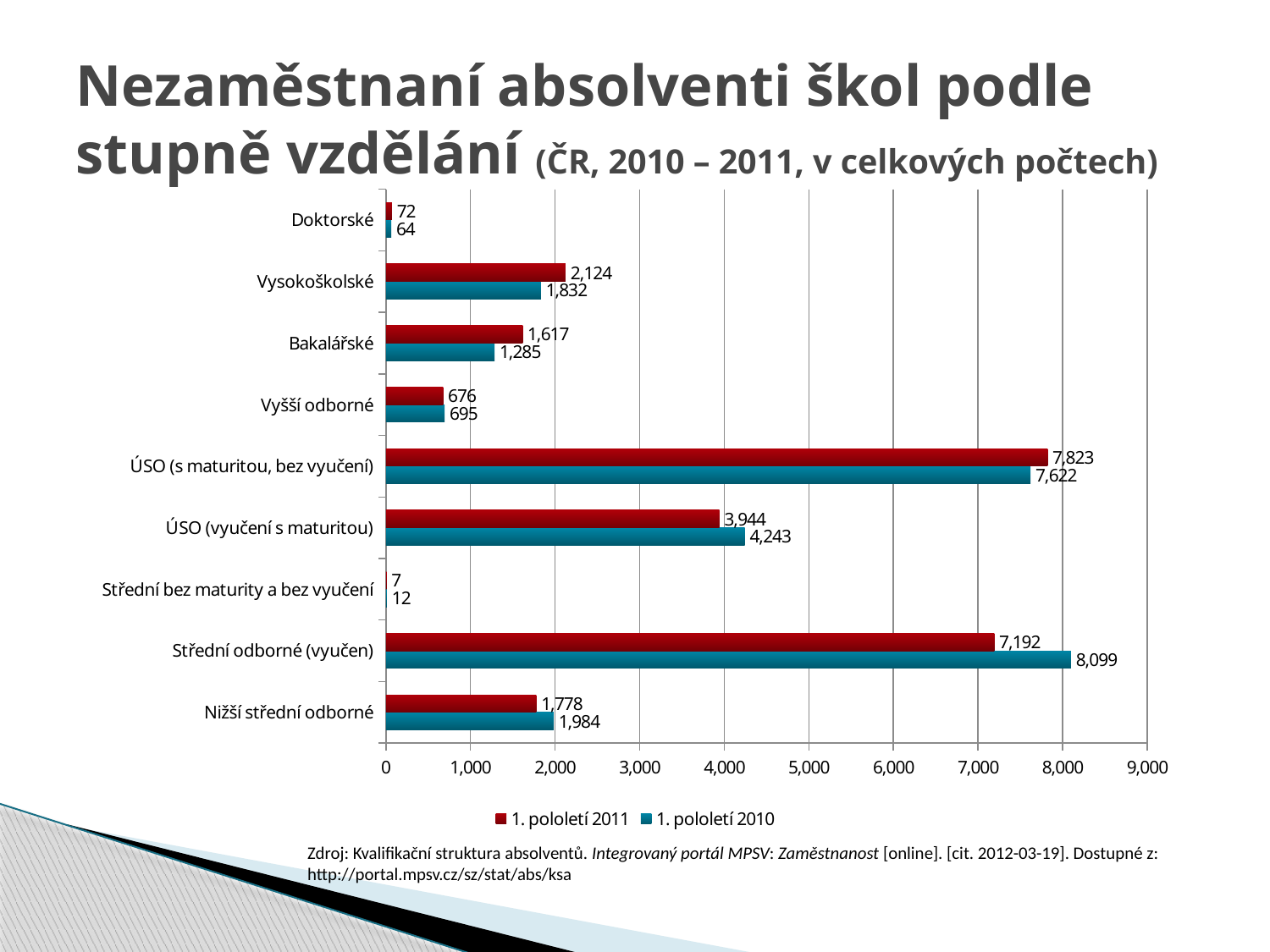
Which is larger for ÚSO (vyučení s maturitou): the 1. pololetí 2011 value or the 1. pololetí 2010 value? 1. pololetí 2010 What is the value for Vysokoškolské in the 1. pololetí 2011 series? 2,124 Which colour represents the 1. pololetí 2011 series? Red How many series does the legend list? 2 Which category has the highest value in the 1. pololetí 2011 series? ÚSO (s maturitou, bez vyučení) What is the value for Doktorské in the 1. pololetí 2010 series? 64 What is the value for Střední odborné (vyučen) in the 1. pololetí 2010 series? 8,099 What kind of chart is shown on the slide? Bar chart What is the difference between the 1. pololetí 2010 and 1. pololetí 2011 values for Střední odborné (vyučen)? 907 Is the value for Bakalářské in the 1. pololetí 2011 series greater or less than 1,000? greater How many education-level categories are shown on the chart? 9 Which category has the lowest value in the 1. pololetí 2010 series? Střední bez maturity a bez vyučení